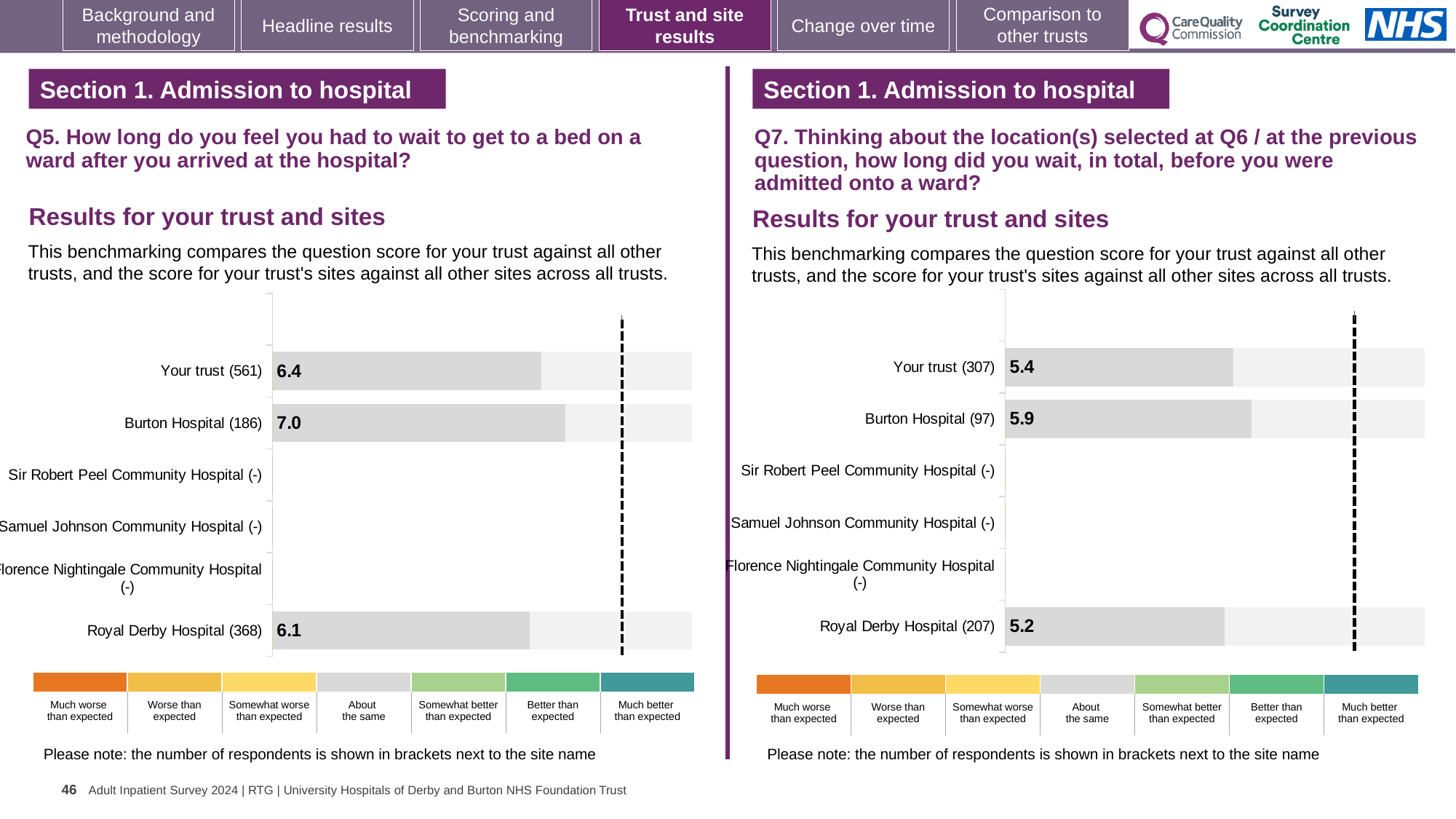
On the left chart (Q5), what is the score for Burton Hospital? 7.0 On the right chart (Q7), what is the score for Royal Derby Hospital? 5.2 How many site/trust categories are listed on the left chart (Q5)? 6 On the right chart (Q7), which site with a plotted score has the lowest score? Royal Derby Hospital What kind of chart is used on the right (Q7)? Bar chart On the right chart (Q7), what is the score for Your trust? 5.4 On the left chart (Q5), which site has the highest score? Burton Hospital On the right chart (Q7), what is the difference between the scores for Burton Hospital and Your trust? 0.5 On the left chart (Q5), what is the score for Your trust? 6.4 On the right chart (Q7), which is larger: the score for Burton Hospital or the score for Royal Derby Hospital? Burton Hospital On the left chart (Q5), how many respondents are shown in brackets for Royal Derby Hospital? 368 On the left chart (Q5), what is the difference between the scores for Burton Hospital and Royal Derby Hospital? 0.9